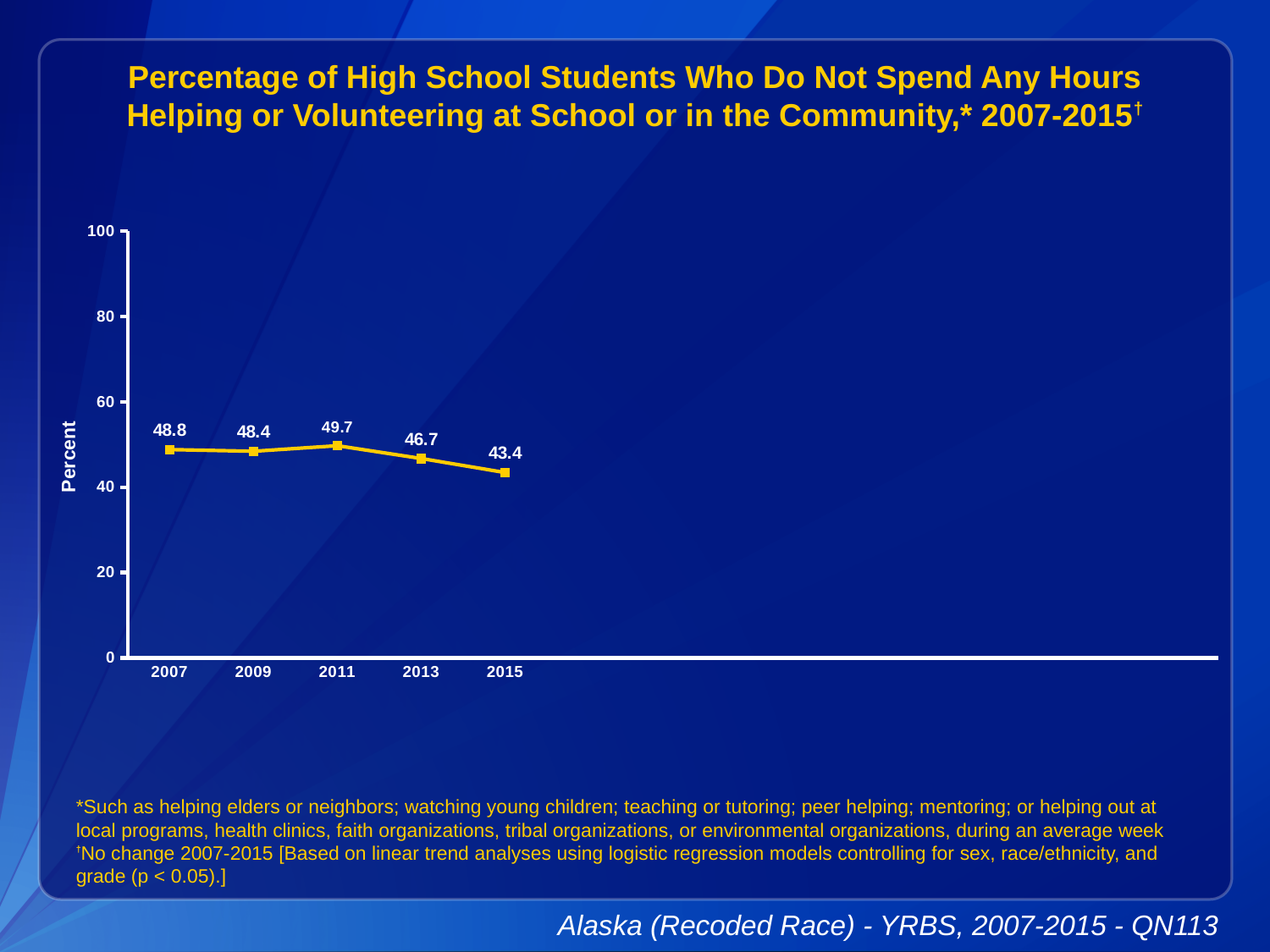
Which year has the highest value? 2011 What is the difference between the values for 2007 and 2015? 5.4 What is the value for 2011? 49.7 Is the value for 2011 greater or less than 60? less What kind of chart is shown on the slide? line chart Which is larger, the value for 2013 or the value for 2015? 2013 What is the value for 2007? 48.8 How many data points are plotted on the chart? 5 What is the label on the y axis? Percent What is the value for 2015? 43.4 Which year has the lowest value? 2015 Do the values rise or fall from 2011 to 2015? fall